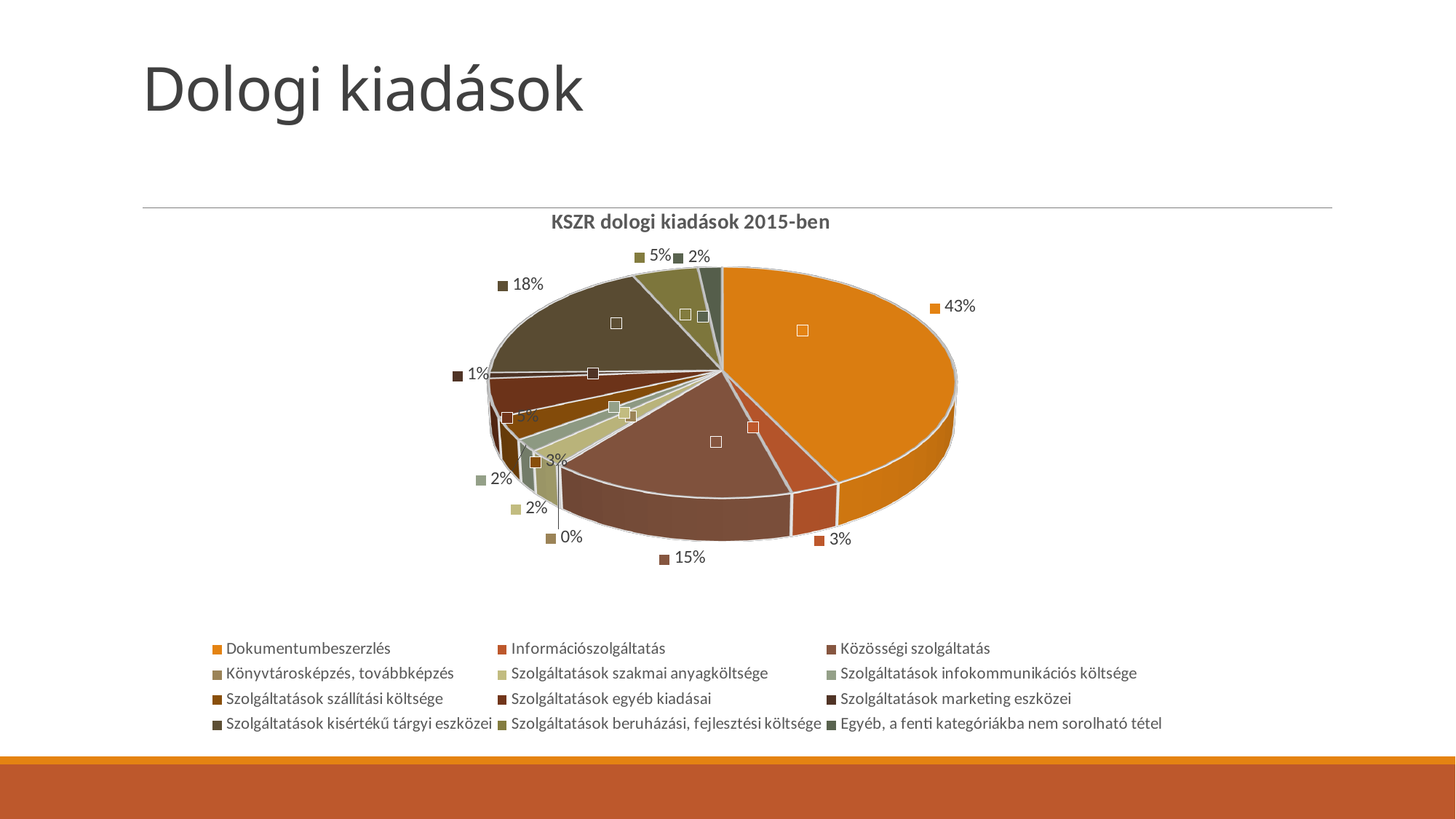
What percentage is shown for Könyvtárosképzés, továbbképzés? 0% Which category has the largest share of the pie? Dokumentumbeszerzlés What is the title of the chart? KSZR dologi kiadások 2015-ben What share of the pie does Dokumentumbeszerzlés have? 43% What percentage is shown for Szolgáltatások kisértékű tárgyi eszközei? 18% Which is larger, the share for Közösségi szolgáltatás or the share for Szolgáltatások kisértékű tárgyi eszközei? Szolgáltatások kisértékű tárgyi eszközei How many categories does the legend of the chart list? 12 What is the difference in percentage points between Dokumentumbeszerzlés and Szolgáltatások kisértékű tárgyi eszközei? 25 percentage points What percentage is shown for Információszolgáltatás? 3% What percentage is shown for Közösségi szolgáltatás? 15% What kind of chart is shown on the slide? Pie chart Which category has the smallest share of the pie? Könyvtárosképzés, továbbképzés